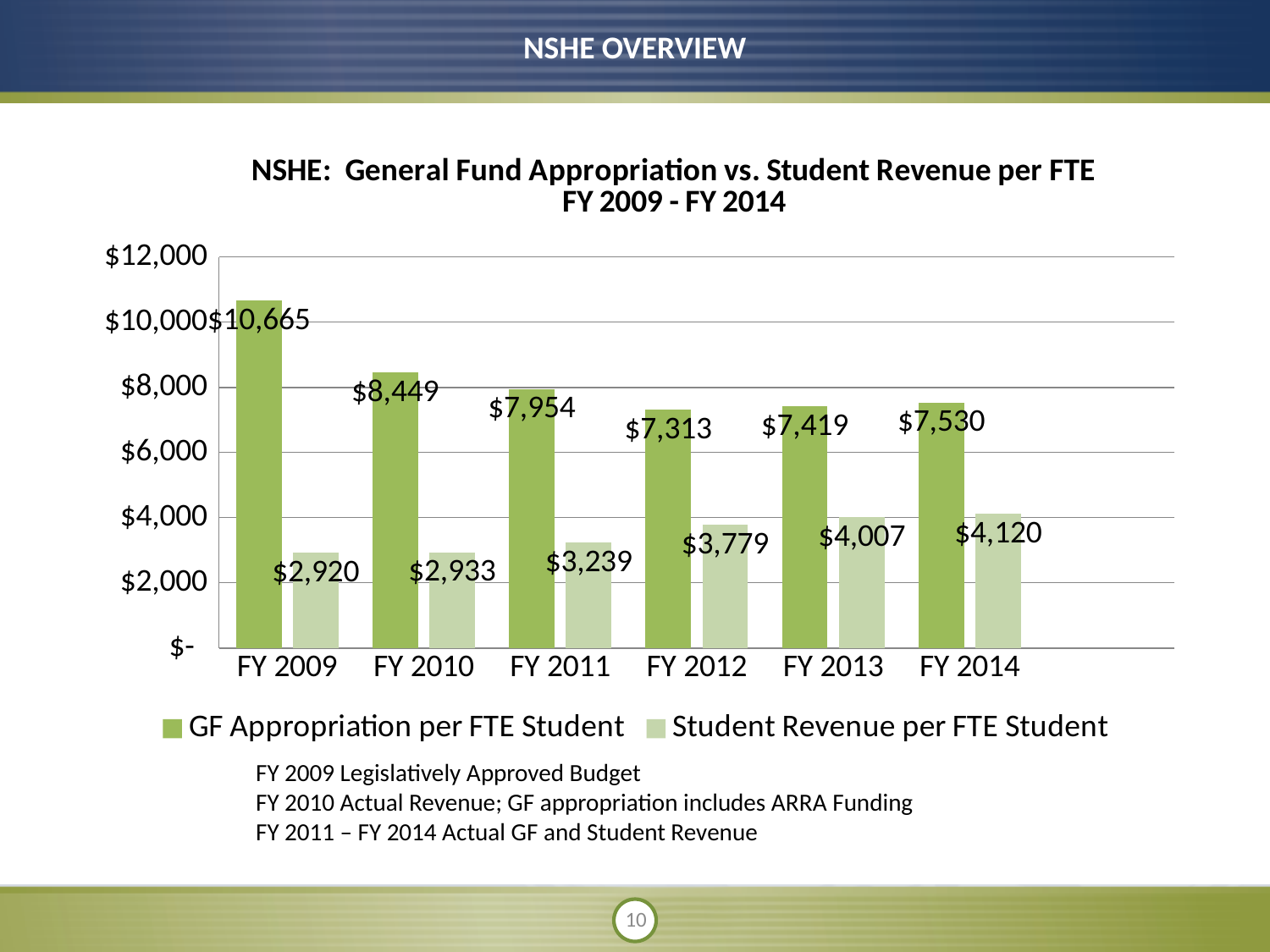
How many fiscal years are shown on the x axis? 6 What is the Student Revenue per FTE Student for FY 2012? $3,779 Does the Student Revenue per FTE Student rise or fall from FY 2009 to FY 2014? Rise What is the GF Appropriation per FTE Student for FY 2009? $10,665 What is the GF Appropriation per FTE Student for FY 2013? $7,419 Which fiscal year has the lowest Student Revenue per FTE Student? FY 2009 Which fiscal year has the highest GF Appropriation per FTE Student? FY 2009 What kind of chart is shown on the slide? Bar chart How many series does the legend list? 2 Which is larger in FY 2011: GF Appropriation per FTE Student or Student Revenue per FTE Student? GF Appropriation per FTE Student What is the difference between the GF Appropriation per FTE Student and the Student Revenue per FTE Student in FY 2014? $3,410 Is the Student Revenue per FTE Student for FY 2013 greater or less than $2,000? greater